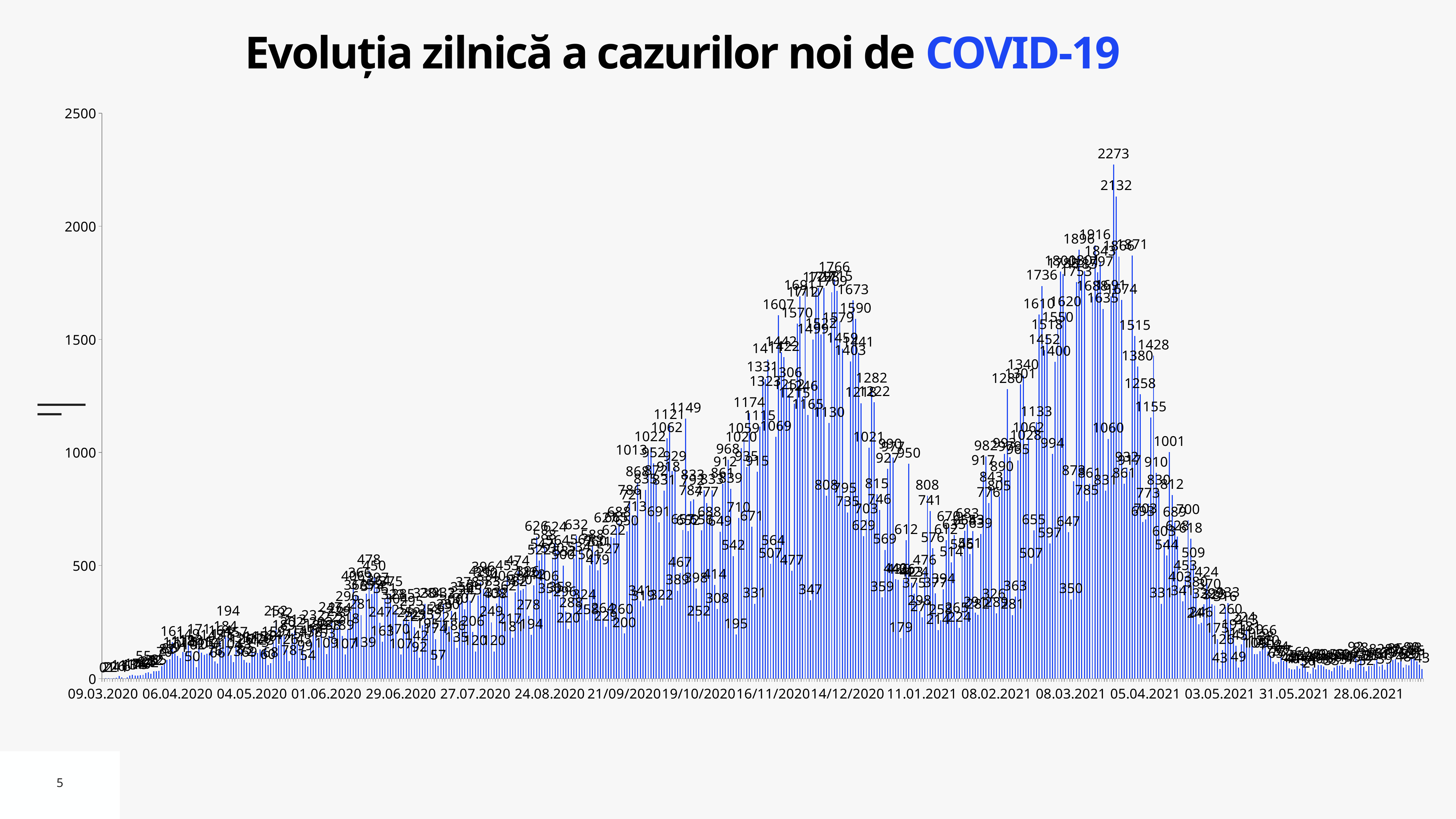
What is the difference between the two highest labelled values, 2273 and 2132? 141 What is the highest daily value shown on the chart? 2273 Are the values at the right end of the x axis (around 28.06.2021) greater or less than 500? less Do the values rise or fall between 31.05.2021 and 28.06.2021 compared with the peak around 05.04.2021? fall Which is larger, the bar labelled 2273 or the bar labelled 2132? 2273 Is the highest value on the chart greater or less than 2000? greater What kind of chart is shown on the slide? bar chart Is the value for the first date, 09.03.2020, greater or less than 500? less What is the title of the chart? Evoluția zilnică a cazurilor noi de COVID-19 What is the highest tick value shown on the vertical axis? 2500 What is the second-highest data label shown, next to the 2273 peak? 2132